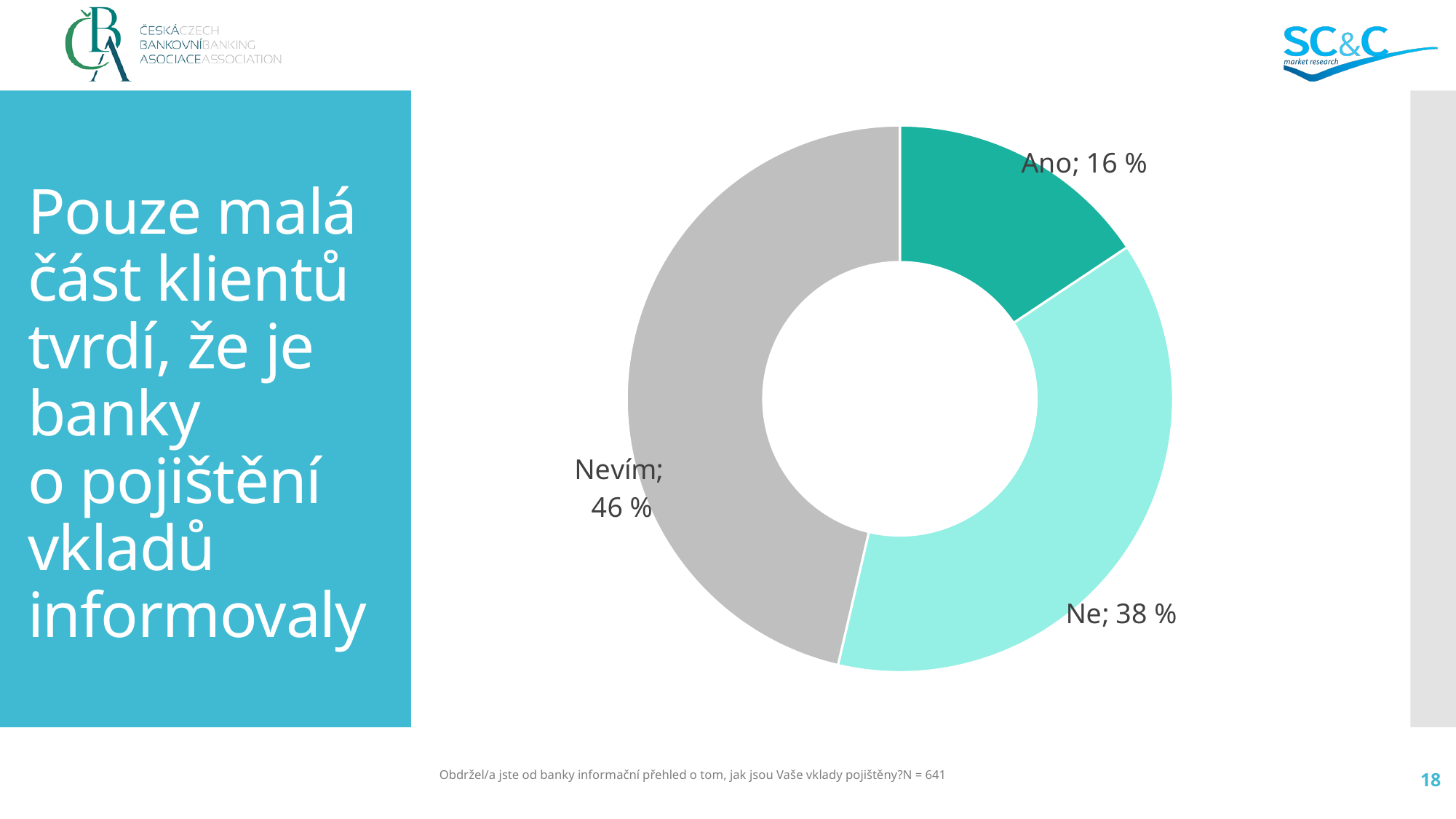
What colour is the "Nevím" slice? Grey What share of respondents answered "Ne"? 38 % What is the difference in percentage points between "Ne" and "Ano"? 22 How many categories are shown in the chart? 3 What kind of chart is shown on the slide? Doughnut (pie) chart What share of respondents answered "Nevím"? 46 % Which category has the largest share of the chart? Nevím What is the difference in percentage points between "Nevím" and "Ano"? 30 Which is larger, the share for "Ne" or the share for "Ano"? Ne What share of respondents answered "Ano"? 16 % Which category has the smallest share of the chart? Ano What is the sample size (N) stated below the chart? 641